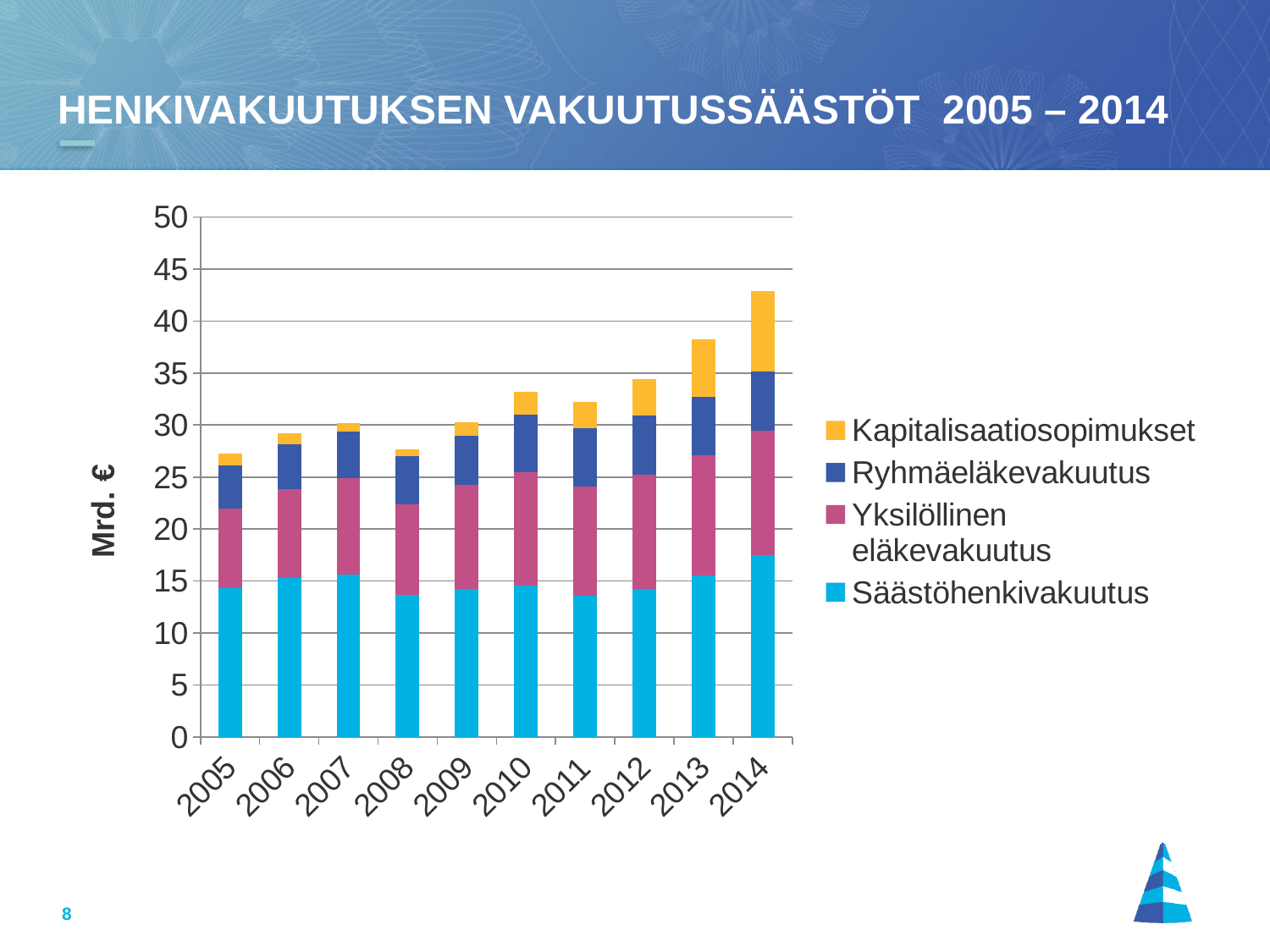
Is the total value for 2005 greater or less than 30? less What unit is shown on the y axis label? Mrd. € Is the Säästöhenkivakuutus value for 2014 greater or less than 15? greater Is the total value for 2014 greater or less than 40? greater How many series does the legend list? 4 How many years are shown on the x axis? 10 What kind of chart is shown on the slide? Stacked bar chart Which year has the highest total insurance savings? 2014 Do the total insurance savings generally rise or fall from 2005 to 2014? Rise Which series is shown in yellow? Kapitalisaatiosopimukset Which is larger, the total for 2014 or the total for 2005? 2014